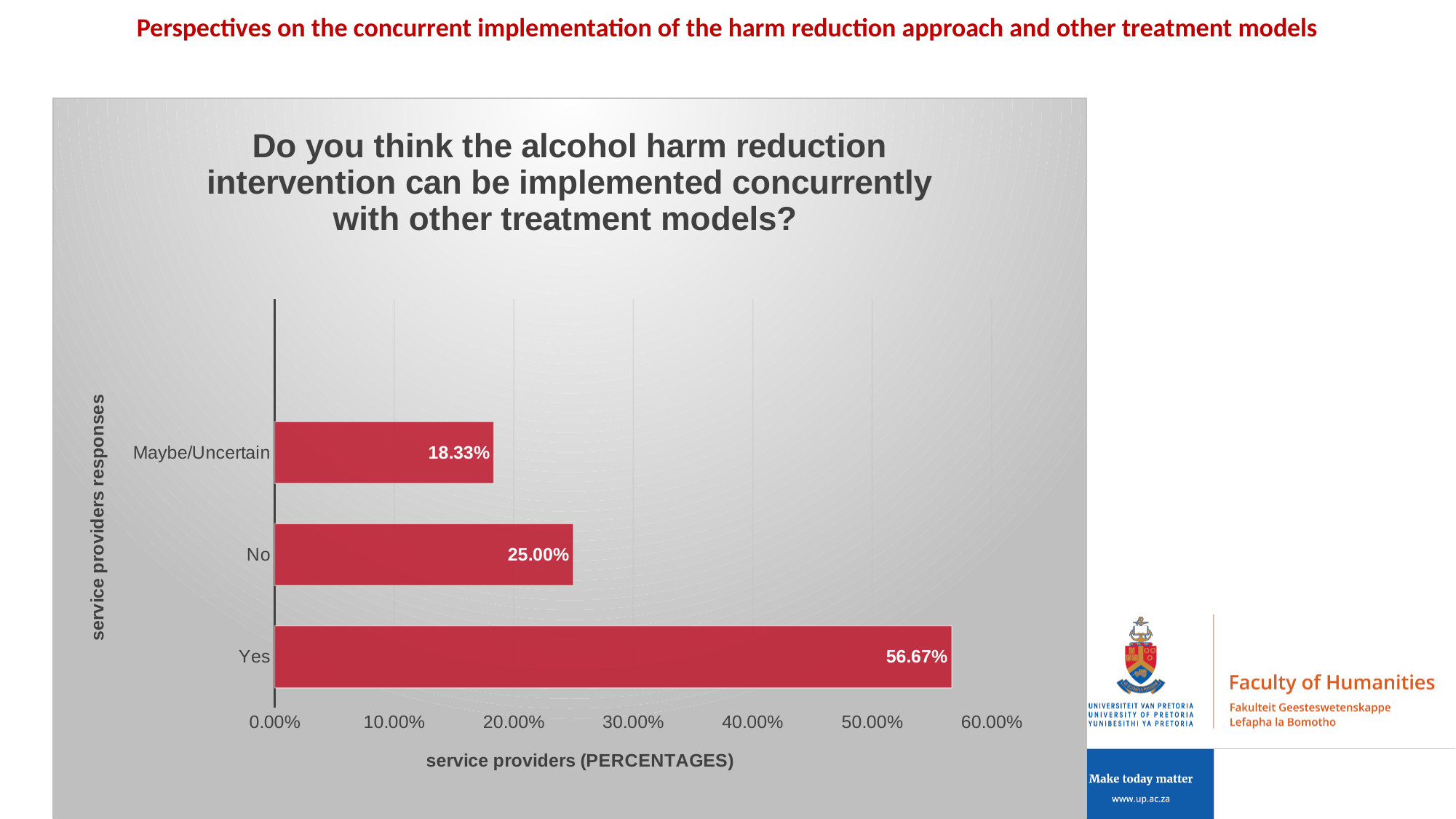
What percentage of service providers answered No? 25.00% What is the difference in percentage points between the Yes and No responses? 31.67% What percentage of service providers answered Yes? 56.67% Which response has a larger percentage, No or Maybe/Uncertain? No How many response categories are shown in the chart? 3 What kind of chart is shown on the slide? Bar chart What percentage of service providers answered Maybe/Uncertain? 18.33% What is the label of the horizontal axis of the chart? service providers (PERCENTAGES) Which response has the lowest percentage? Maybe/Uncertain What is the difference in percentage points between the No and Maybe/Uncertain responses? 6.67% Which response has the highest percentage? Yes Is the value for Yes greater or less than 50.00%? greater